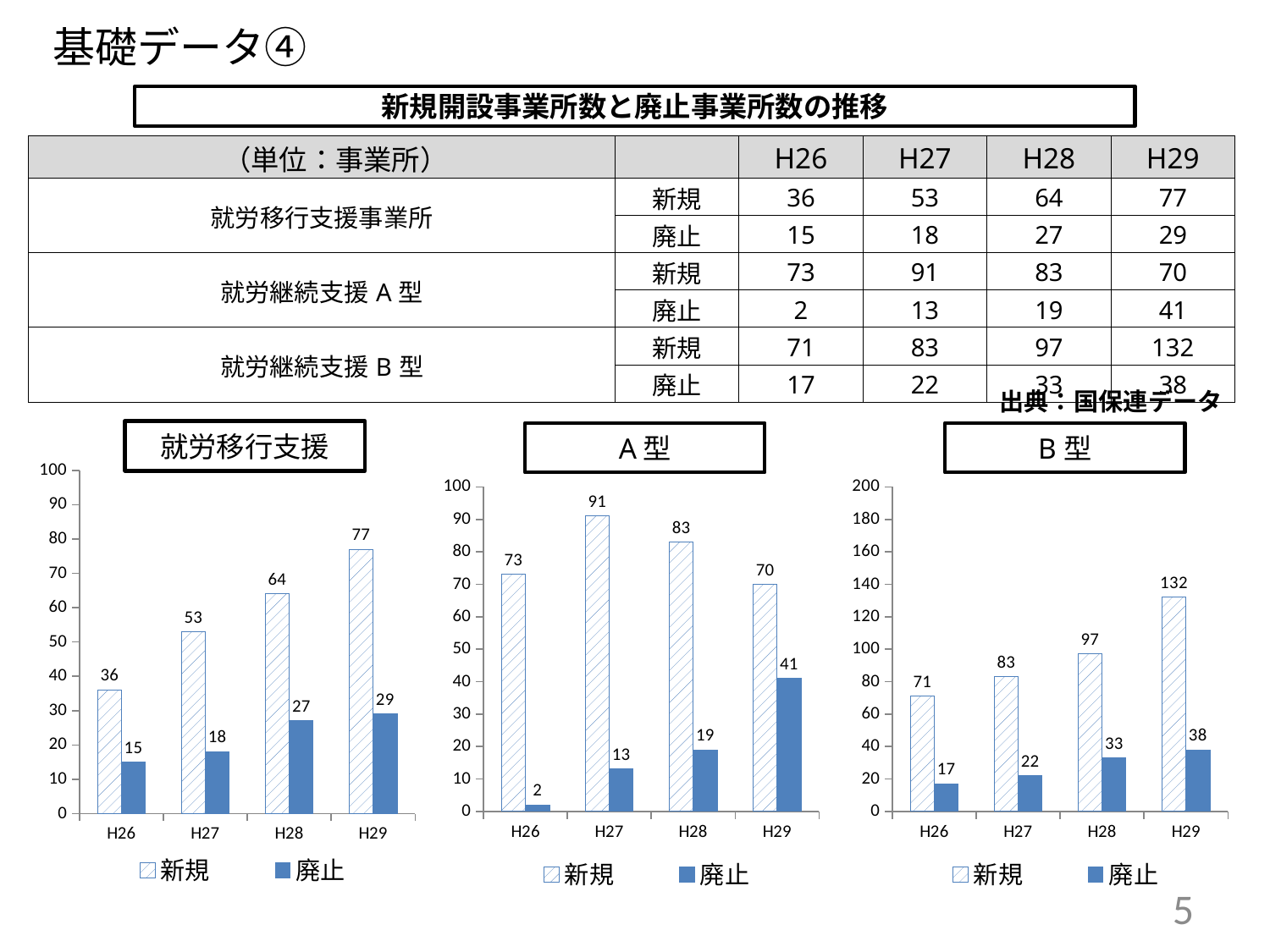
In the B型 chart, what is the value of 新規 for H28? 97 How many series does the legend of the A型 chart list? 2 In the 就労移行支援 chart, do the 新規 values rise or fall from H26 to H29? rise In the B型 chart, is the value of 新規 for H29 greater or less than 120? greater What kind of chart is the B型 chart? bar chart In the A型 chart, what is the value of 廃止 for H26? 2 In the 就労移行支援 chart, what is the value of 新規 for H29? 77 In the 就労移行支援 chart, which year has the lowest 廃止 value? H26 In the B型 chart, what is the difference between 新規 and 廃止 for H29? 94 In the A型 chart, which is larger: 新規 for H28 or 新規 for H29? 新規 for H28 How many years are shown on the x axis of the 就労移行支援 chart? 4 In the A型 chart, which year has the highest 新規 value? H27